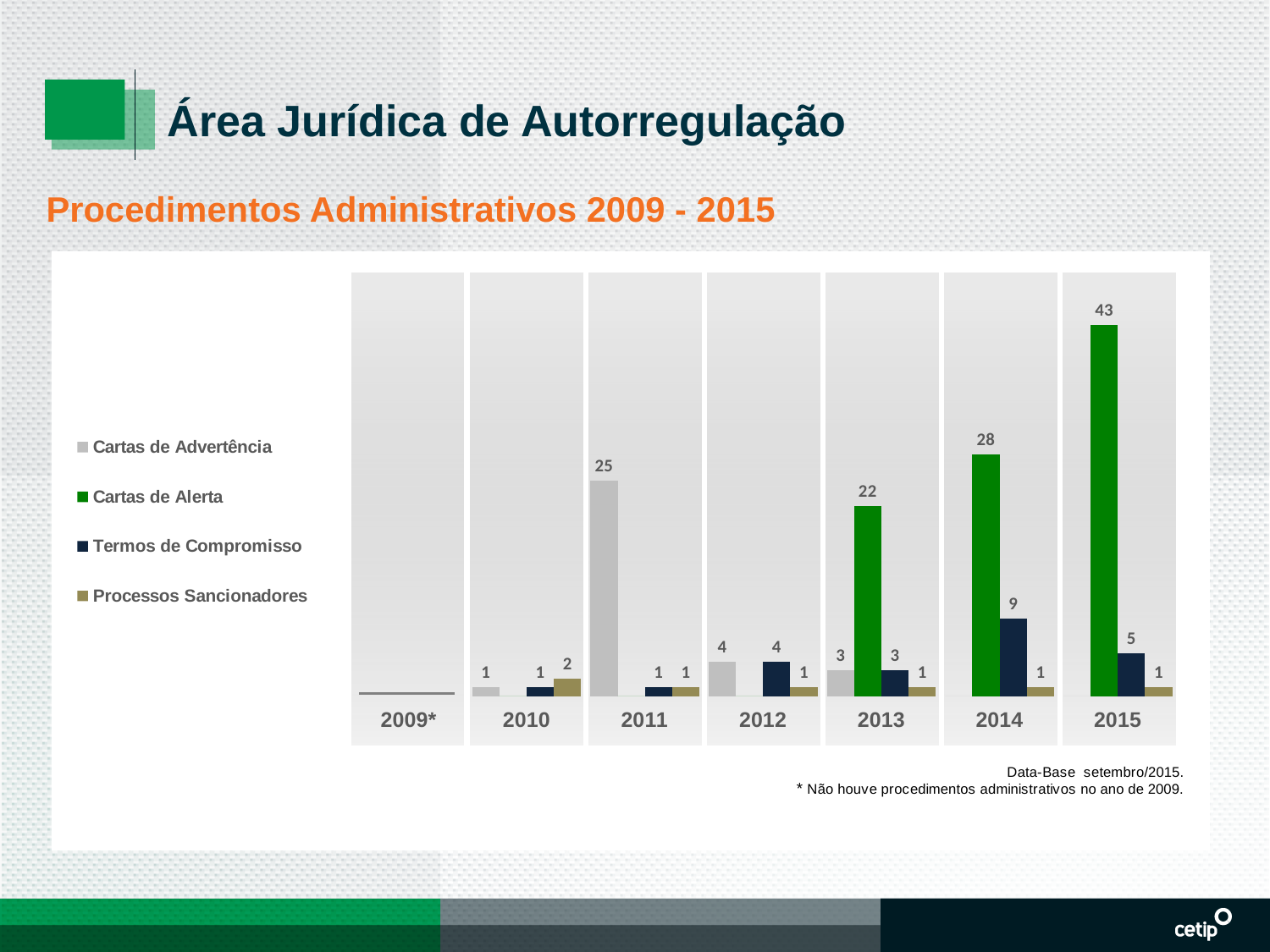
What is the value of Cartas de Alerta in 2015? 43 Which is larger in 2013: Cartas de Alerta or Cartas de Advertência? Cartas de Alerta In which year is Cartas de Alerta highest? 2015 How many series does the legend list? 4 What type of chart is shown on the slide? bar chart How many years are shown on the x axis of the chart? 7 What is the difference between Cartas de Alerta in 2015 and in 2014? 15 What is the value of Termos de Compromisso in 2014? 9 What is the value of Cartas de Advertência in 2011? 25 What is the value of Processos Sancionadores in 2010? 2 Do the values for Cartas de Alerta rise or fall from 2013 to 2015? rise According to the footnote, which year had no administrative procedures? 2009